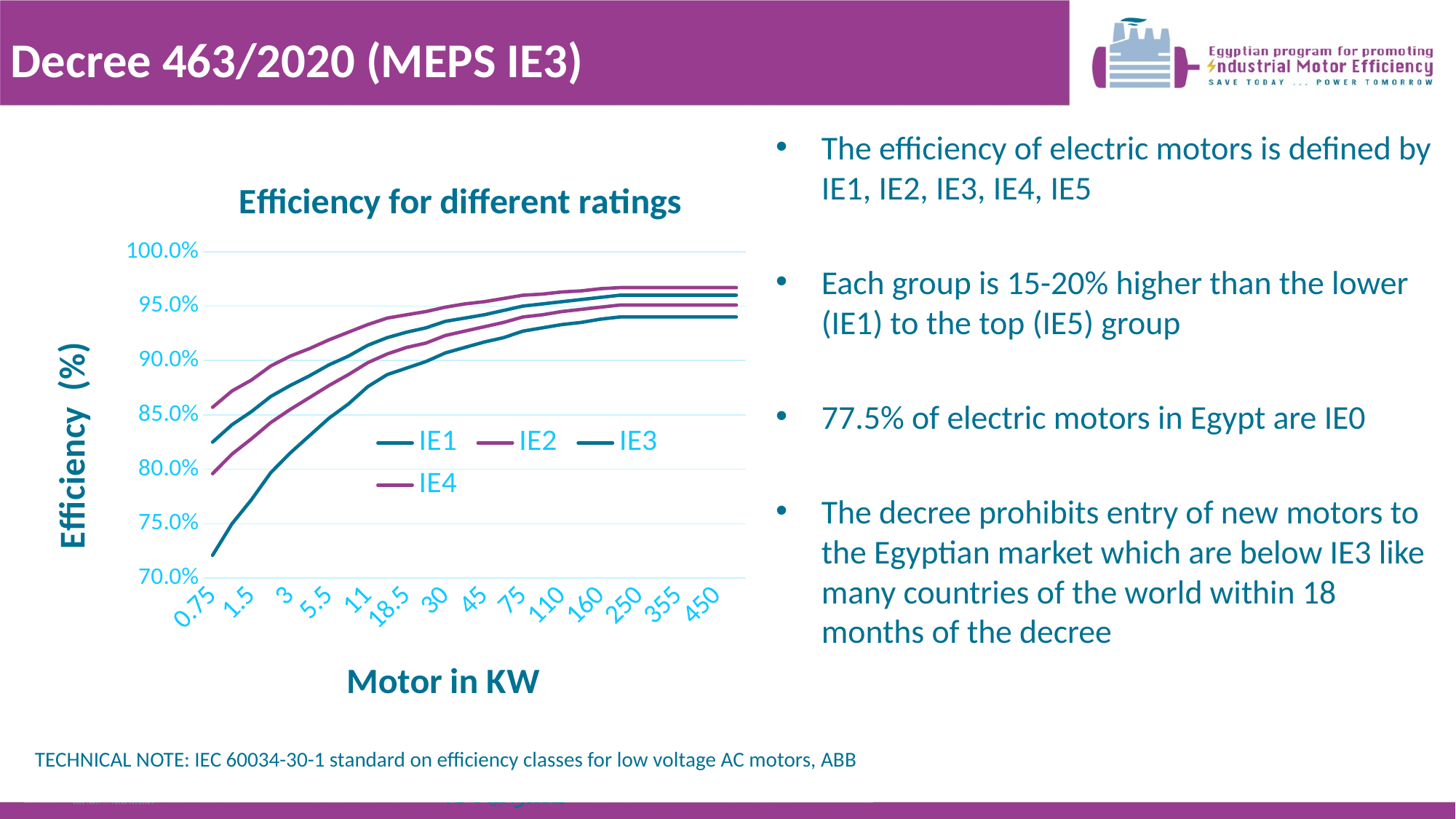
Which series has the lowest efficiency at the 0.75 kW rating? IE1 Do the efficiency values rise or fall as the motor rating increases along the x axis? rise How many motor ratings (categories) are shown on the x axis? 14 Is the IE4 efficiency at 450 kW greater or less than 95.0%? greater What is the label of the chart's x axis? Motor in KW Is the IE1 efficiency at 450 kW greater or less than 95.0%? less What kind of chart is shown on the slide? line chart At 0.75 kW, which series has the larger efficiency, IE4 or IE1? IE4 Is the IE1 efficiency at 0.75 kW greater or less than 75.0%? less How many series does the chart's legend list? 4 Which series has the highest efficiency at the 0.75 kW rating? IE4 What is the title of the chart? Efficiency for different ratings